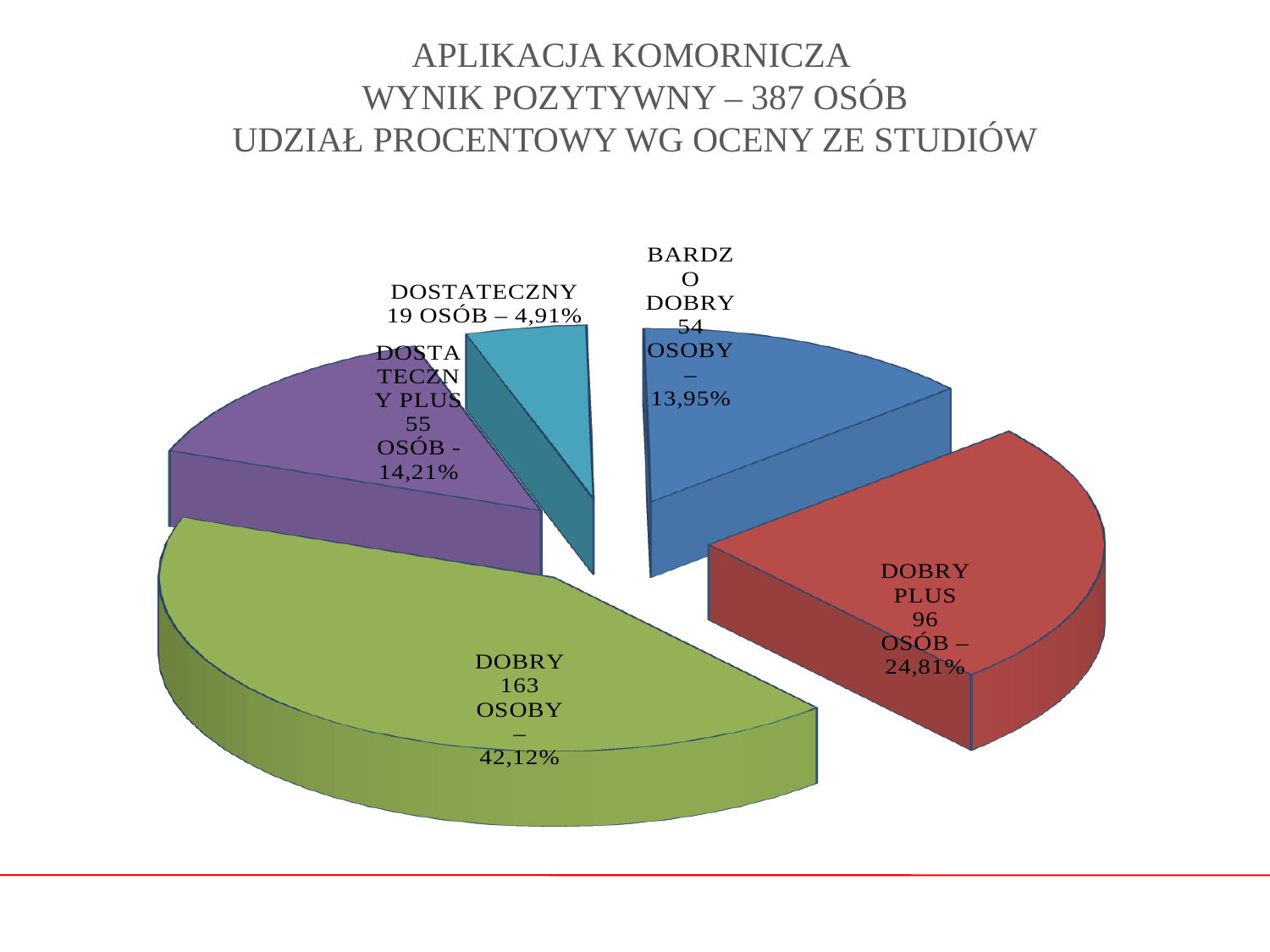
What percentage is shown for BARDZO DOBRY? 13,95% How many slices does the pie chart have? 5 What is the difference in number of people between DOBRY and DOBRY PLUS? 67 Which category has the largest share of the pie? DOBRY What percentage is shown for DOSTATECZNY PLUS? 14,21% What percentage share is shown for the DOBRY slice? 42,12% Which has more people, BARDZO DOBRY or DOSTATECZNY PLUS? DOSTATECZNY PLUS How many people are in the DOBRY PLUS category? 96 How many people are in the DOSTATECZNY category? 19 What kind of chart is shown on the slide? pie chart Which category has the smallest share of the pie? DOSTATECZNY According to the title, how many people had a positive result (WYNIK POZYTYWNY)? 387